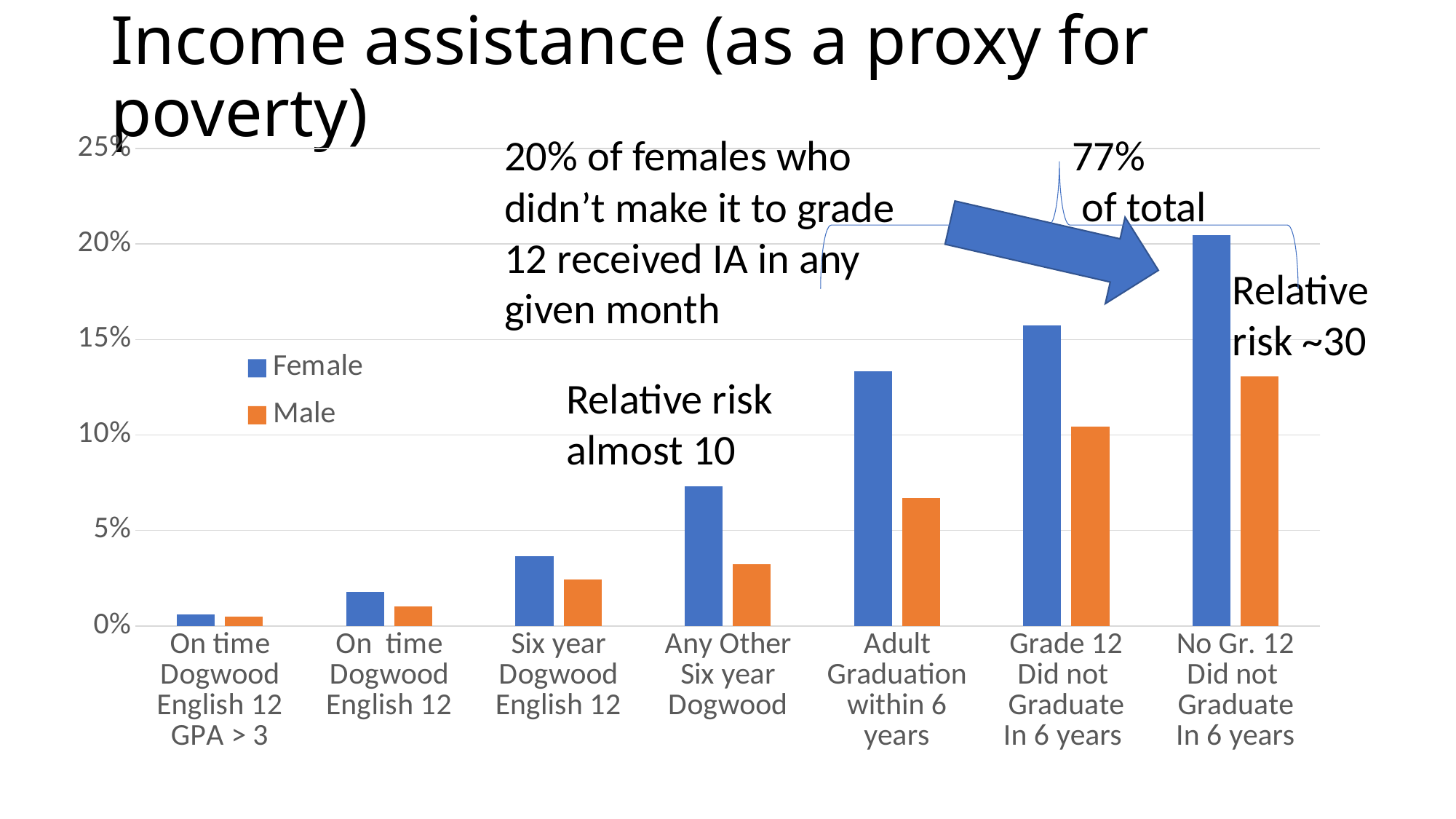
Is the Female value for Grade 12 Did not Graduate In 6 years greater or less than 10%? greater Is the Male value for No Gr. 12 Did not Graduate In 6 years greater or less than 15%? less Is the Female value for Adult Graduation within 6 years greater or less than 10%? greater Which category has the lowest Male value? On time Dogwood English 12 GPA > 3 What kind of chart is shown on the slide? Bar chart How many categories are shown along the x axis of the chart? 7 How many series does the chart's legend list? 2 Which colour represents the Male series in the chart? Orange Do the Female values generally rise or fall moving from left to right along the x axis? Rise Which category has the highest Female value? No Gr. 12 Did not Graduate In 6 years For Adult Graduation within 6 years, which is larger, the Female value or the Male value? Female